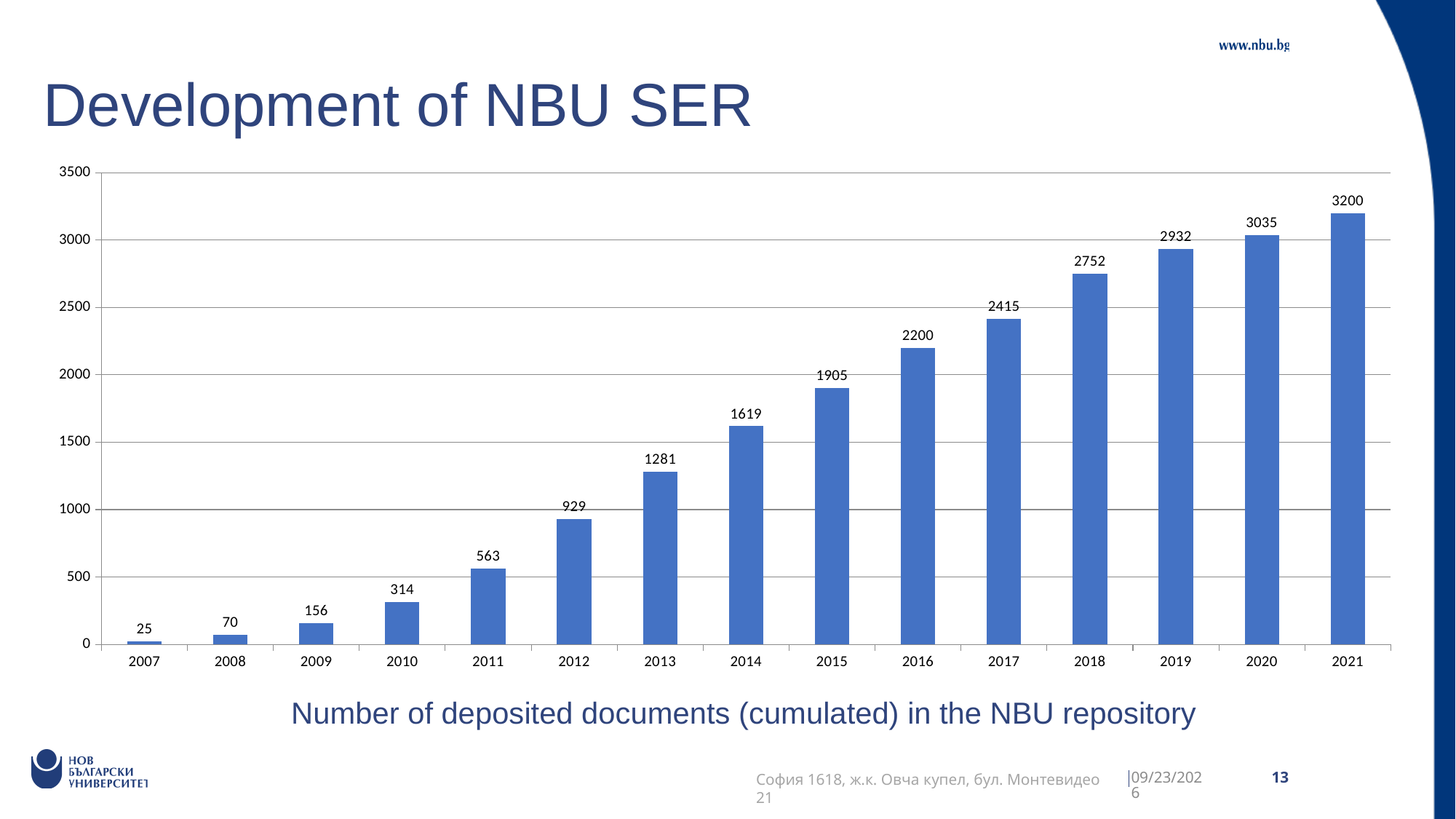
Which is larger, the value for 2014 or the value for 2016? 2016 What kind of chart is shown on the slide? bar chart How many years are shown on the x axis? 15 Which year has the highest number of deposited documents? 2021 What is the value shown for 2019? 2932 What is the difference between the values for 2021 and 2020? 165 What is the difference between the values for 2013 and 2012? 352 Is the value for 2017 greater or less than 2500? less Which year has the lowest number of deposited documents? 2007 What is the value shown for 2010? 314 Do the values rise or fall from 2007 to 2021? rise What is the number of deposited documents in 2015? 1905